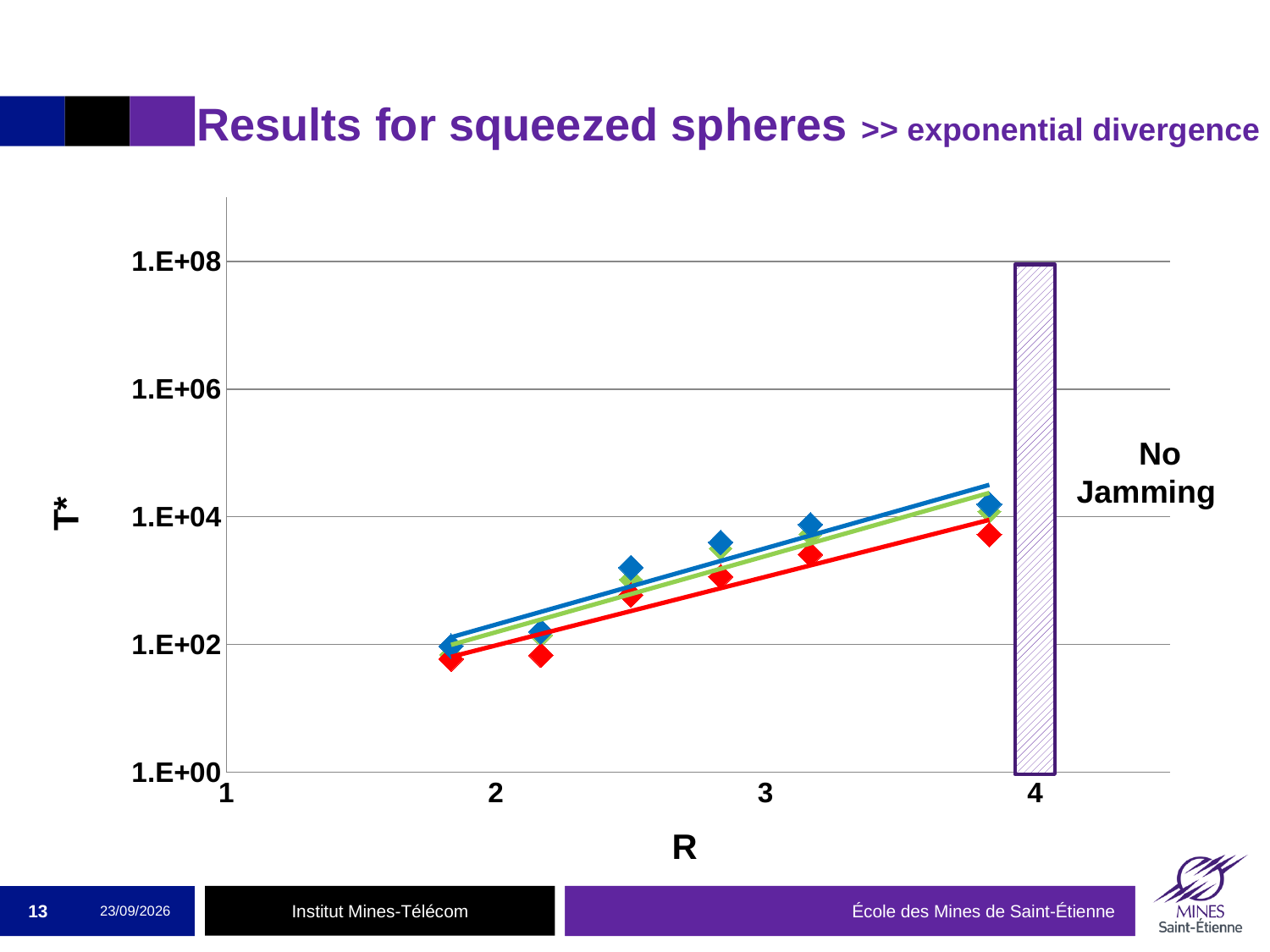
What is the label of the y axis? T* How many data series (colours of diamond markers) are plotted? 3 Is the red series value at its rightmost point (R just below 4) greater or less than 1.E+04? less At the rightmost data point (R just below 4), is the blue series value larger or the red series value? blue How many data points does the blue series have? 6 Which series has the lowest T* values overall: blue, green or red? red Is the blue series value at R of about 2.5 greater or less than 1.E+02? greater Which series has the highest T* values overall: blue, green or red? blue What is the label of the x axis? R What kind of chart is shown on the slide? scatter chart Is the red series value at its leftmost point (R just below 2) greater or less than 1.E+02? less Do the plotted T* values rise or fall as R increases? rise